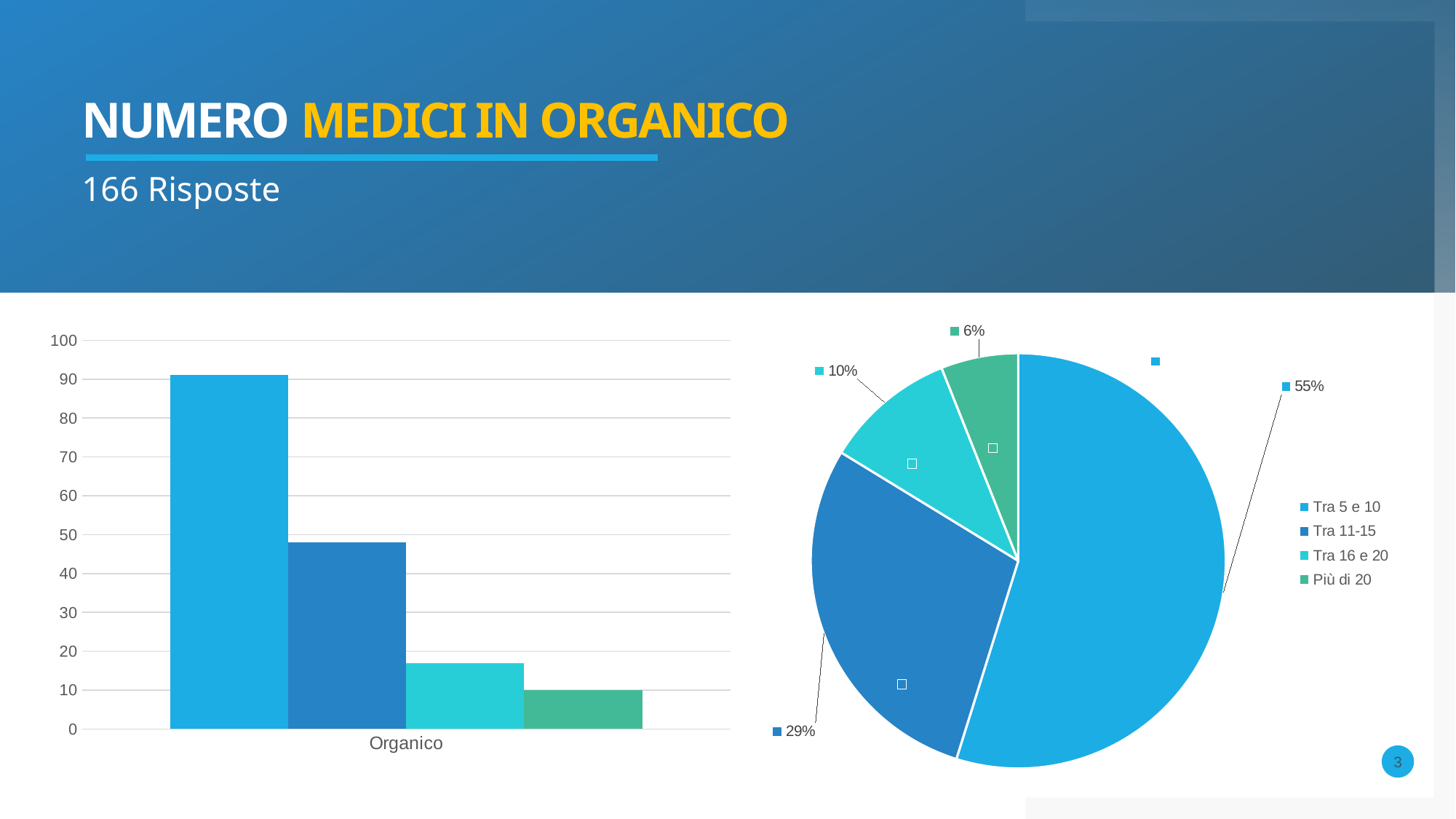
In the pie chart on the right, what share is shown for 'Tra 11-15'? 29% In the bar chart on the left, is the value of the third bar greater or less than 20? less In the pie chart on the right, what share is shown for 'Tra 5 e 10'? 55% In the pie chart on the right, which category has the largest slice? Tra 5 e 10 In the pie chart on the right, what is the difference in percentage points between 'Tra 5 e 10' and 'Tra 11-15'? 26 In the pie chart on the right, what share is shown for 'Tra 16 e 20'? 10% What kind of chart is the chart on the left of the slide? bar chart In the pie chart on the right, which category has the smallest slice? Più di 20 How many entries does the legend of the pie chart on the right list? 4 In the bar chart on the left, is the value of the tallest (first) bar greater or less than 80? greater What kind of chart is the chart on the right of the slide? pie chart